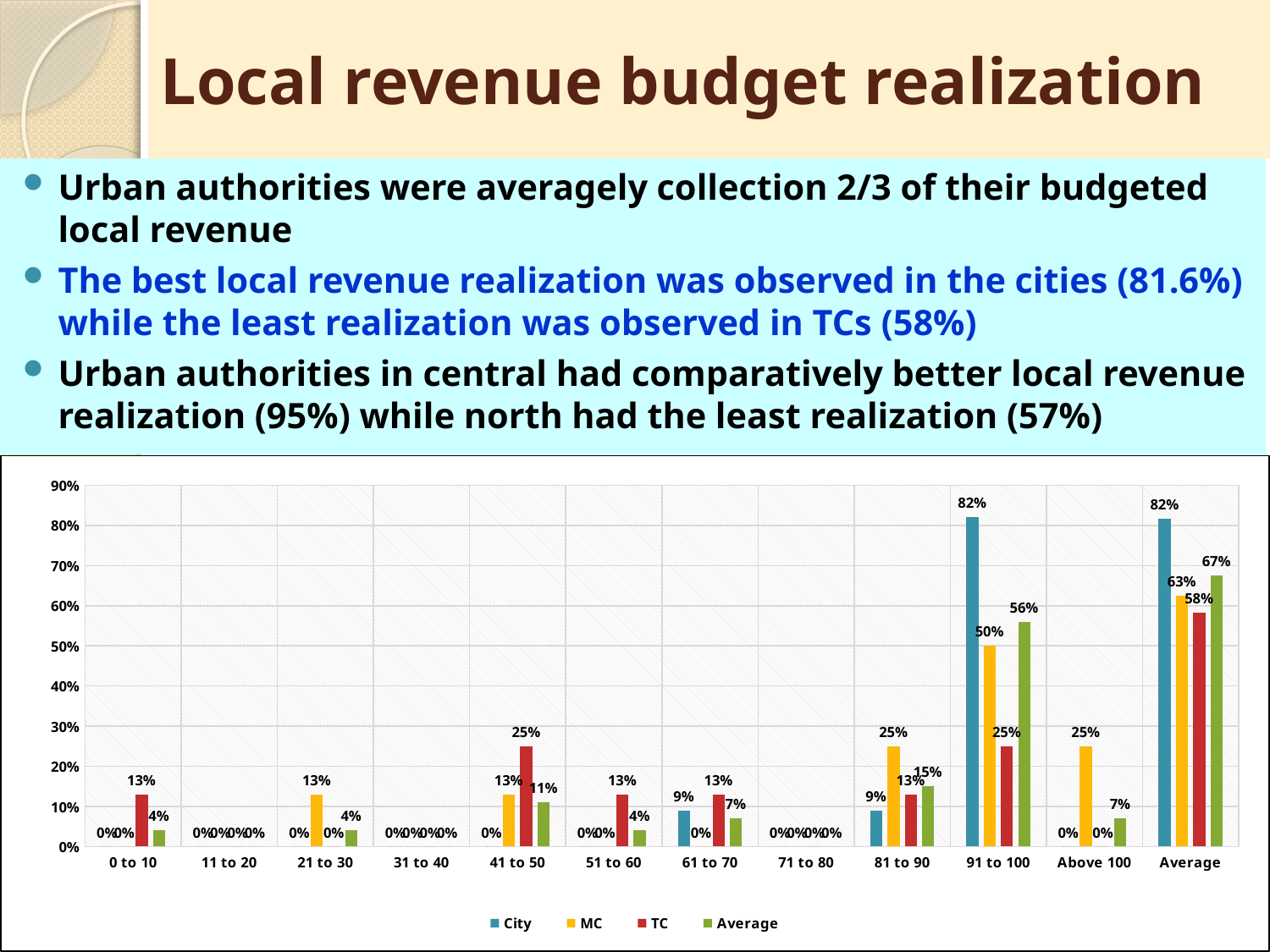
What is the difference between the City and TC values in the Average category? 24% What kind of chart is shown on the slide? bar chart How many series does the legend list? 4 What is the value for MC in the Average category? 63% How many categories are shown on the x axis? 12 What is the value for City in the 91 to 100 category? 82% What is the Average series value in the 81 to 90 category? 15% In the 81 to 90 category, which is larger, the MC value or the TC value? MC What is the value for TC in the 41 to 50 category? 25% Which series is shown in red in the legend? TC Which series has the highest value in the 91 to 100 category? City Which series has the lowest value in the Average category? TC